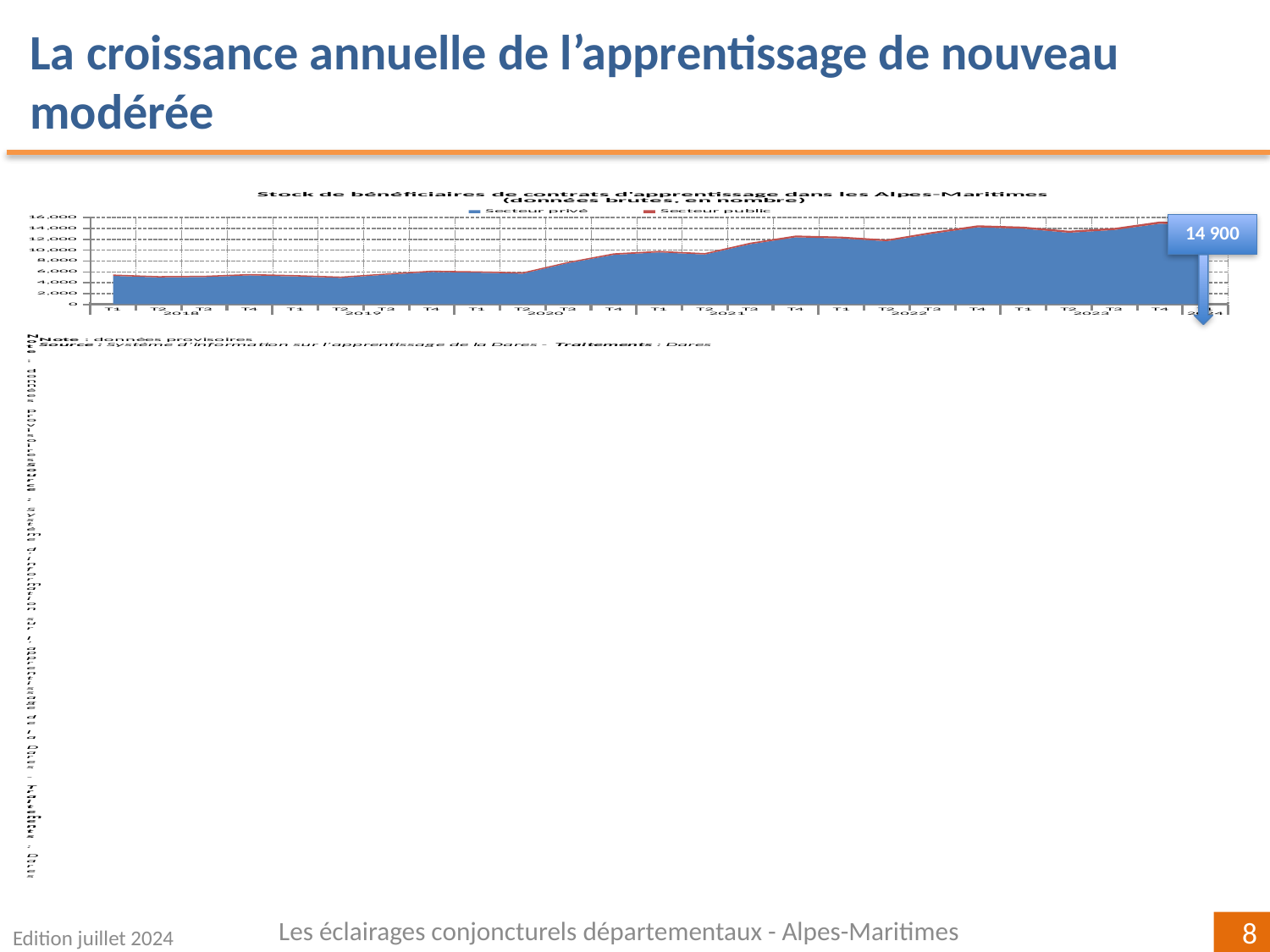
Which series, Secteur privé or Secteur public, accounts for the larger share of the stock? Secteur privé What is the title of the chart? Stock de bénéficiaires de contrats d'apprentissage dans les Alpes-Maritimes (données brutes, en nombre) How many years are labelled on the x axis of the chart? 7 What are the two series named in the chart legend? Secteur privé and Secteur public What kind of chart is shown on the slide? Area chart Is the total value at T1 2018 greater or less than 6,000? less How many series does the chart legend list? 2 Is the total value at T1 2024 greater or less than 14,000? greater Do the values generally rise or fall from 2018 to 2024? Rise Is the total value at T1 2020 greater or less than 8,000? less What value is shown in the callout for the latest point (T1 2024)? 14 900